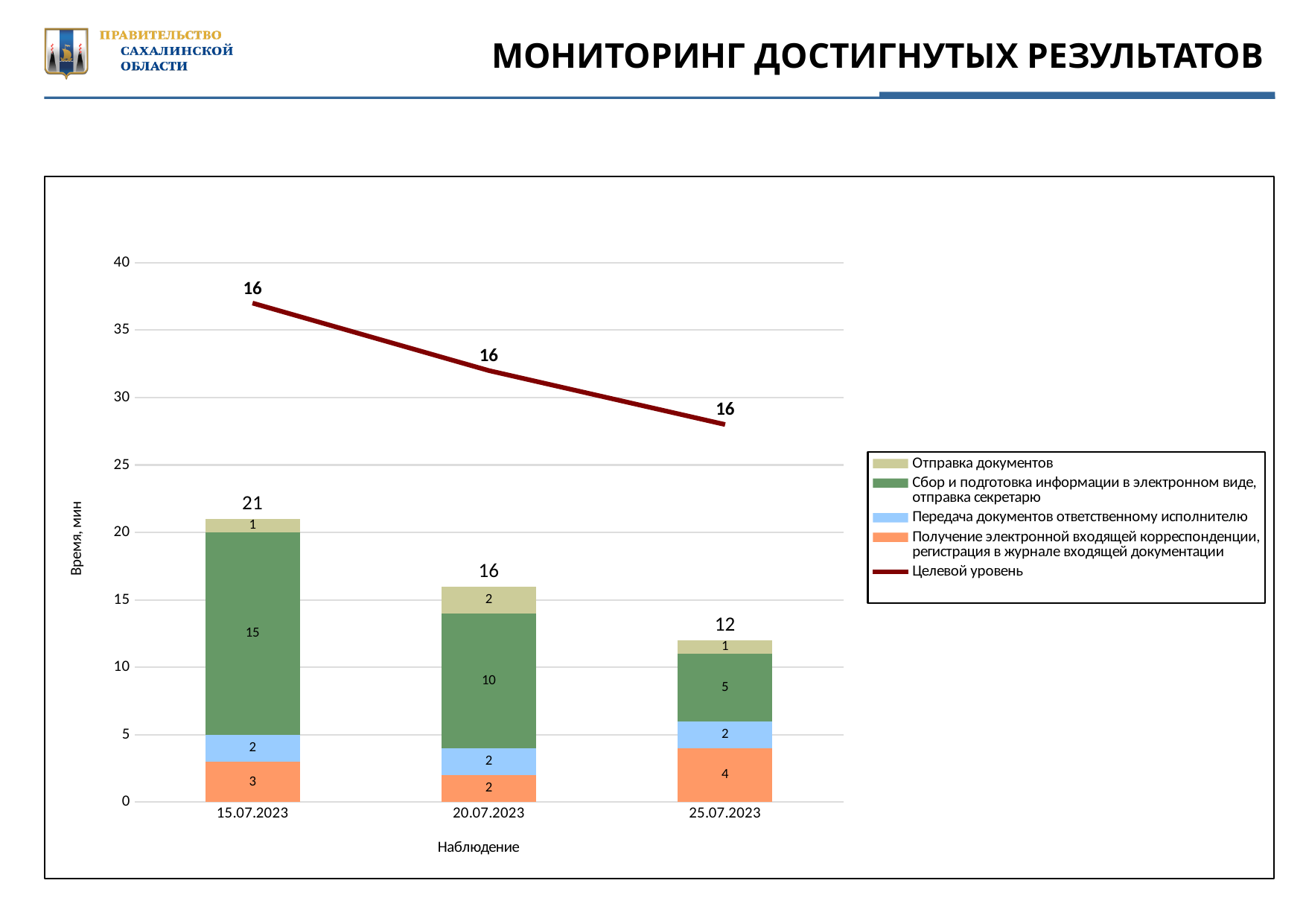
How many observation dates are shown on the x axis? 3 Do the stacked bar totals rise or fall from 15.07.2023 to 25.07.2023? fall What is the total of the stacked bar for 25.07.2023? 12 What is the value of the 'Получение электронной входящей корреспонденции, регистрация в журнале входящей документации' segment for 25.07.2023? 4 What is the total of the stacked bar for 15.07.2023? 21 What is the value of the 'Отправка документов' segment for 20.07.2023? 2 How many series does the legend list? 5 What is the labelled value of the 'Целевой уровень' line at 15.07.2023? 16 What is the value of the 'Сбор и подготовка информации в электронном виде, отправка секретарю' segment for 20.07.2023? 10 What is the difference between the stacked bar totals for 15.07.2023 and 25.07.2023? 9 Which observation date has the highest stacked bar total? 15.07.2023 Which observation date has the lowest stacked bar total? 25.07.2023